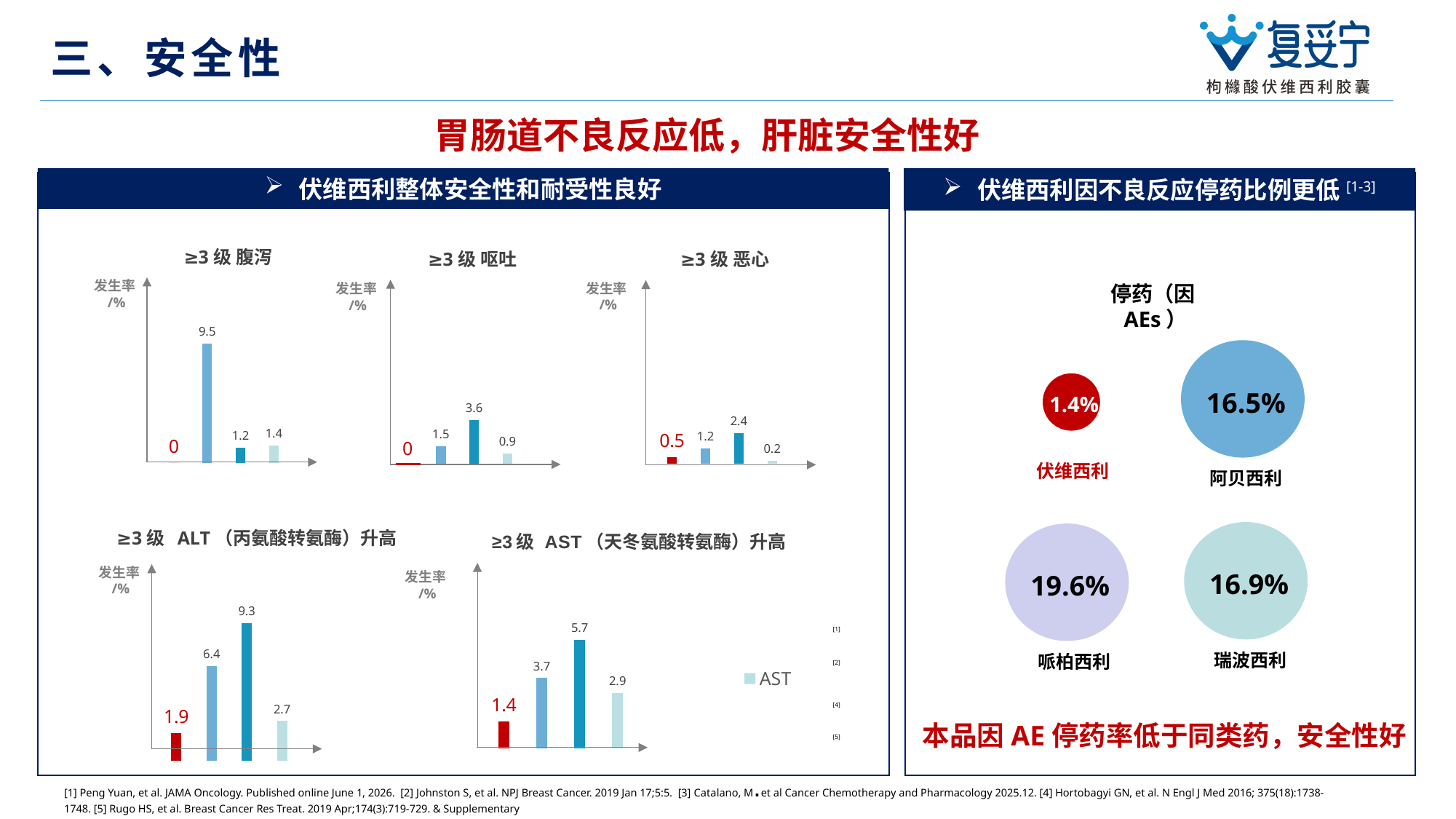
In the "≥3 级 恶心" chart, what is the lowest value shown? 0.2 In the "≥3 级 呕吐" chart, what is the value of the tallest bar? 3.6 In the "≥3 级 恶心" chart, what is the value of the red (first) bar? 0.5 In the "≥3 级 AST（天冬氨酸转氨酶）升高" chart, what is the value of the red (first) bar? 1.4 In the "≥3 级 ALT（丙氨酸转氨酶）升高" chart, what is the difference between the tallest bar (9.3) and the red bar (1.9)? 7.4 In the "≥3 级 腹泻" chart, what is the value of the red (first) bar? 0 In the "≥3 级 AST（天冬氨酸转氨酶）升高" chart, how many bars are plotted? 4 In the "≥3 级 腹泻" chart, what is the highest value shown? 9.5 In the "停药（因AEs）" chart on the right, what is the value for 阿贝西利? 16.5% In the "≥3 级 ALT（丙氨酸转氨酶）升高" chart, what is the value of the tallest bar? 9.3 In the "停药（因AEs）" chart on the right, what is the difference between 瑞波西利 and 伏维西利? 15.5%